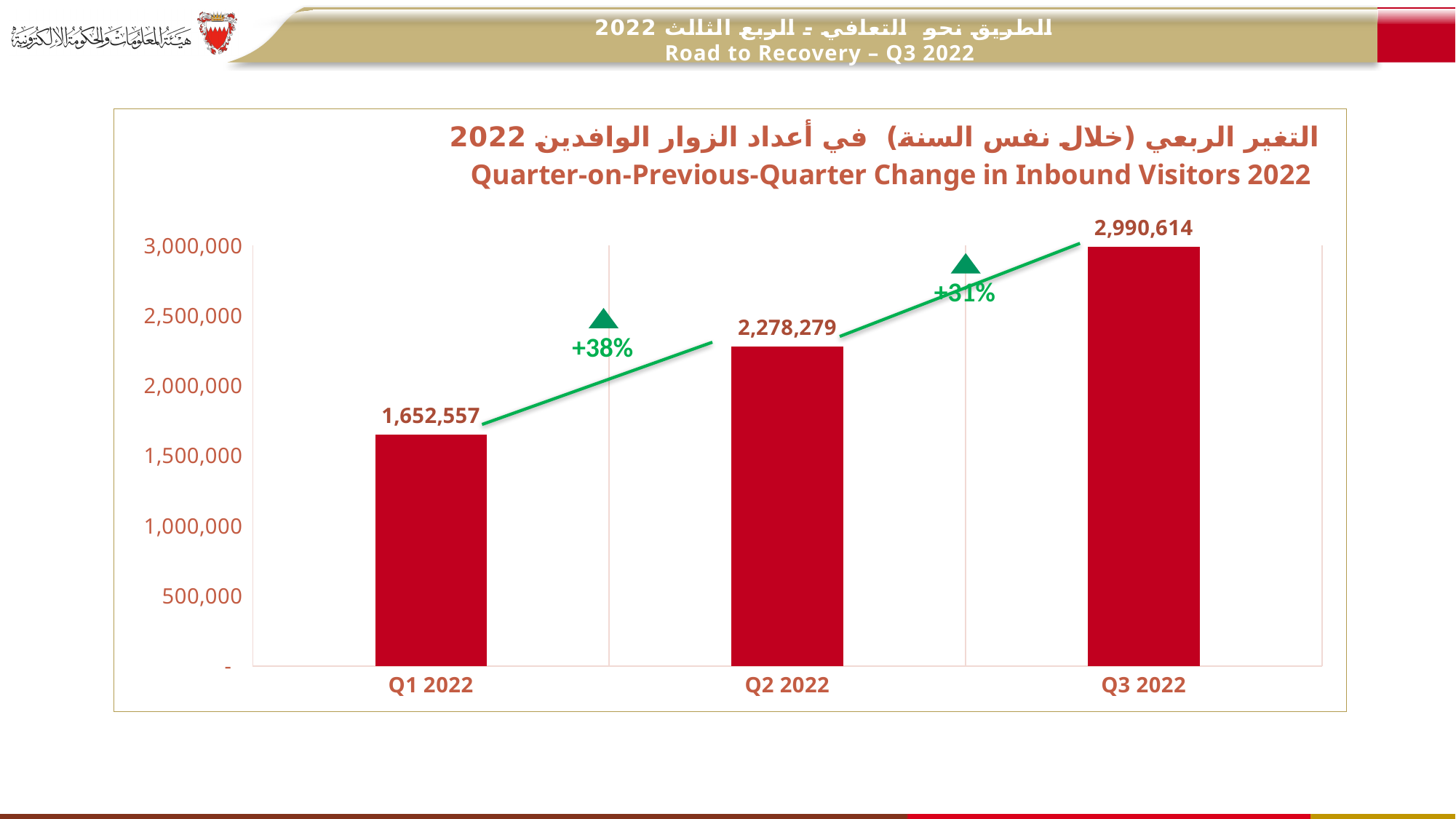
What is the difference between the values for Q2 2022 and Q1 2022? 625,722 How many quarters are shown on the chart? 3 What percentage change is annotated between Q1 2022 and Q2 2022? +38% What is the value for Q1 2022? 1,652,557 Which quarter has the lowest number of inbound visitors? Q1 2022 Which quarter has the highest number of inbound visitors? Q3 2022 Is the value for Q3 2022 greater or less than 2,500,000? greater What is the difference between the values for Q3 2022 and Q2 2022? 712,335 Which is larger, the value for Q2 2022 or Q1 2022? Q2 2022 What is the value for Q3 2022? 2,990,614 What kind of chart is this? bar chart What is the value for Q2 2022? 2,278,279